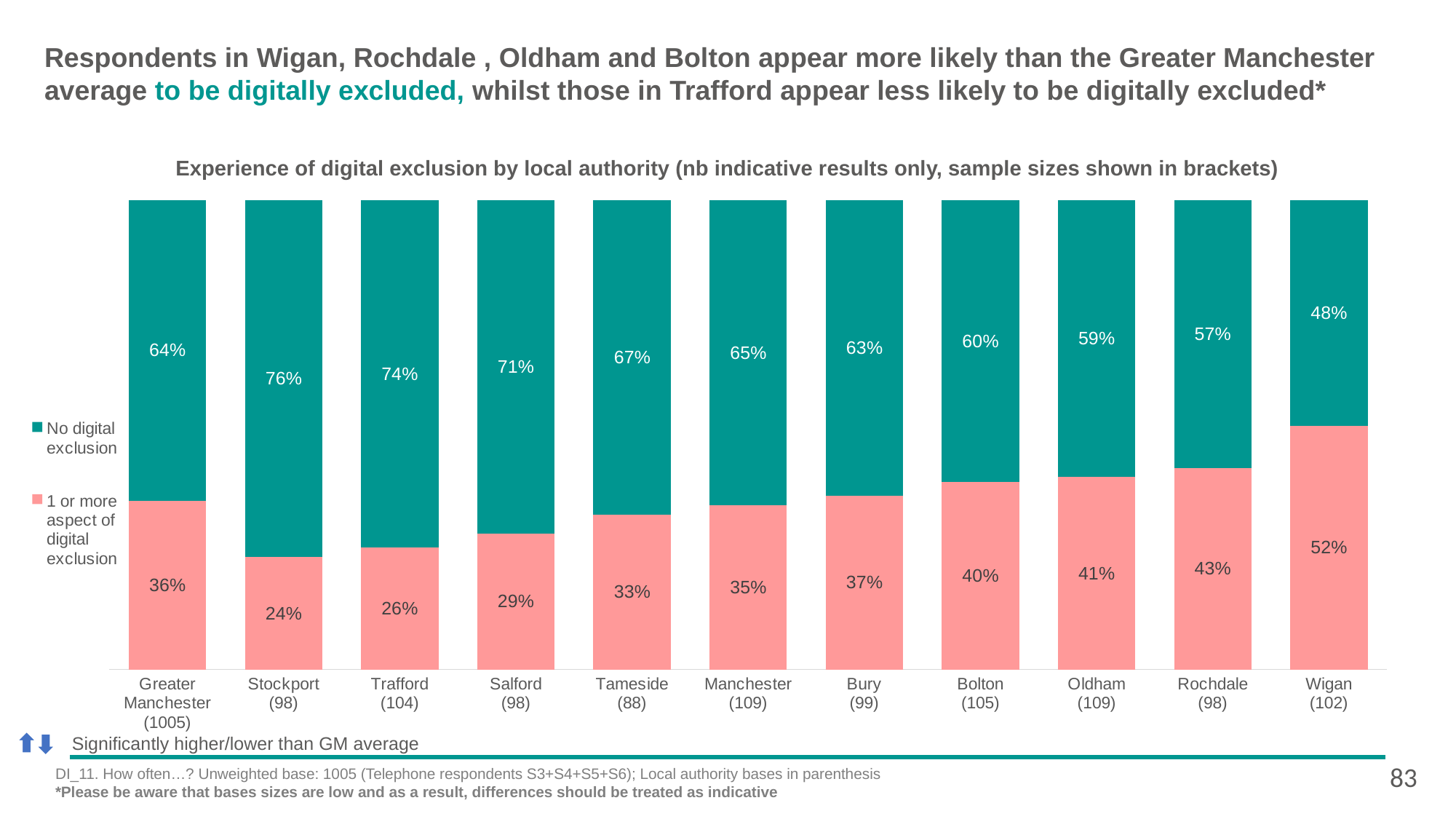
Which local authority has the highest share of respondents with 1 or more aspect of digital exclusion? Wigan How many local authority categories are shown on the x axis, including Greater Manchester? 11 How many series does the legend list? 2 What is the total of the stacked bar for Rochdale? 100% What percentage of Stockport respondents report no digital exclusion? 76% Which has a larger share of respondents with no digital exclusion, Salford or Bolton? Salford What percentage of Wigan respondents report 1 or more aspect of digital exclusion? 52% What is the difference between Wigan's and Trafford's values for 1 or more aspect of digital exclusion? 26 percentage points Which local authority has the lowest share of respondents with 1 or more aspect of digital exclusion? Stockport What is the value for 1 or more aspect of digital exclusion for Greater Manchester? 36% What kind of chart is shown on the slide? Stacked bar chart What is the sample size shown in brackets for Tameside? 88